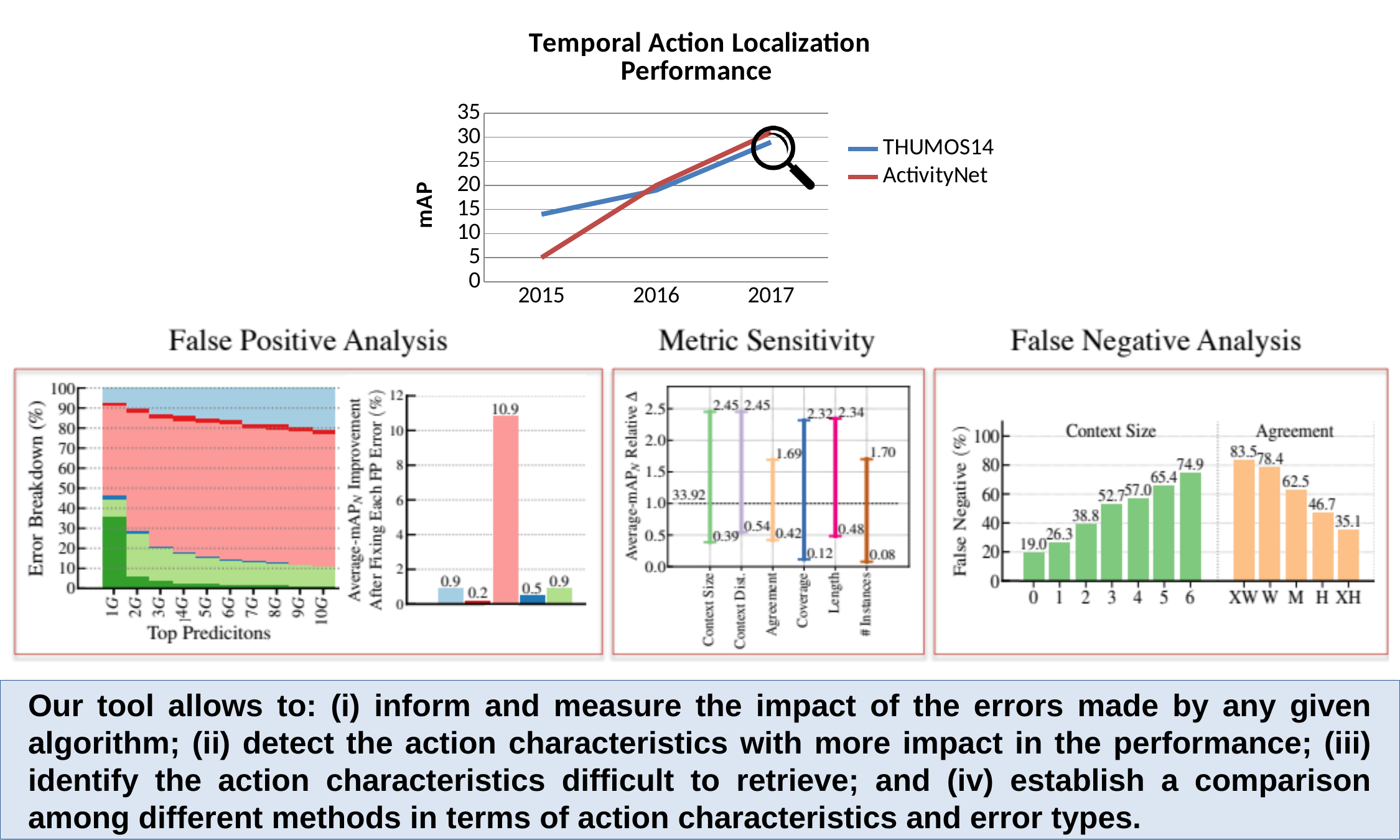
In the Temporal Action Localization Performance chart, does the ActivityNet mAP rise or fall from 2015 to 2017? rise In the Temporal Action Localization Performance chart, which series has the higher mAP in 2015? THUMOS14 In the Temporal Action Localization Performance chart, how many years are shown on the x axis? 3 In the False Negative Analysis chart, which Agreement category has the highest false negative value? XW In the False Positive Analysis bar chart, what is the highest average-mAP improvement value shown? 10.9 In the Temporal Action Localization Performance chart, how many series does the legend list? 2 In the Temporal Action Localization Performance chart, what kind of chart is used? line chart In the False Negative Analysis chart, what is the difference between the false negative values for XW and XH? 48.4 In the False Negative Analysis chart, what is the false negative value for context size 6? 74.9 In the Metric Sensitivity chart, what is the upper value shown for Coverage? 2.32 In the Temporal Action Localization Performance chart, is the ActivityNet value for 2015 greater or less than 10? less In the Temporal Action Localization Performance chart, is the THUMOS14 value for 2017 greater or less than 25? greater